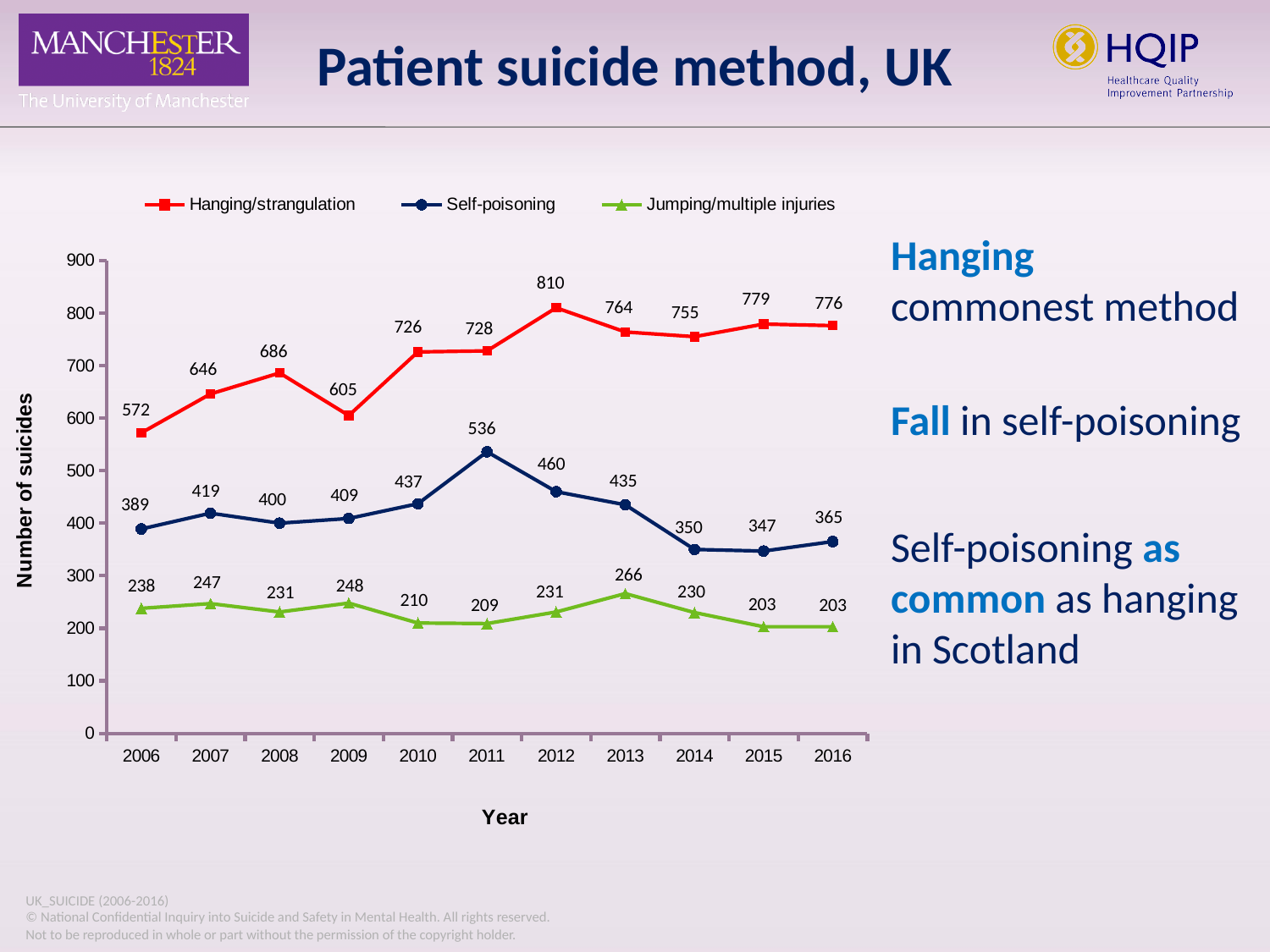
What was the number of suicides by jumping/multiple injuries in 2013? 266 Did self-poisoning suicides rise or fall between 2011 and 2015? Fall In which year was the number of hanging/strangulation suicides highest? 2012 What kind of chart is shown on the slide? Line chart What is the label of the y axis? Number of suicides In which year was the number of self-poisoning suicides lowest? 2015 What was the number of suicides by hanging/strangulation in 2012? 810 What was the number of suicides by self-poisoning in 2011? 536 How many series does the legend list? 3 How many years are shown on the x axis? 11 Which was higher in 2009: self-poisoning or jumping/multiple injuries? Self-poisoning What is the difference between hanging/strangulation and self-poisoning suicides in 2016? 411